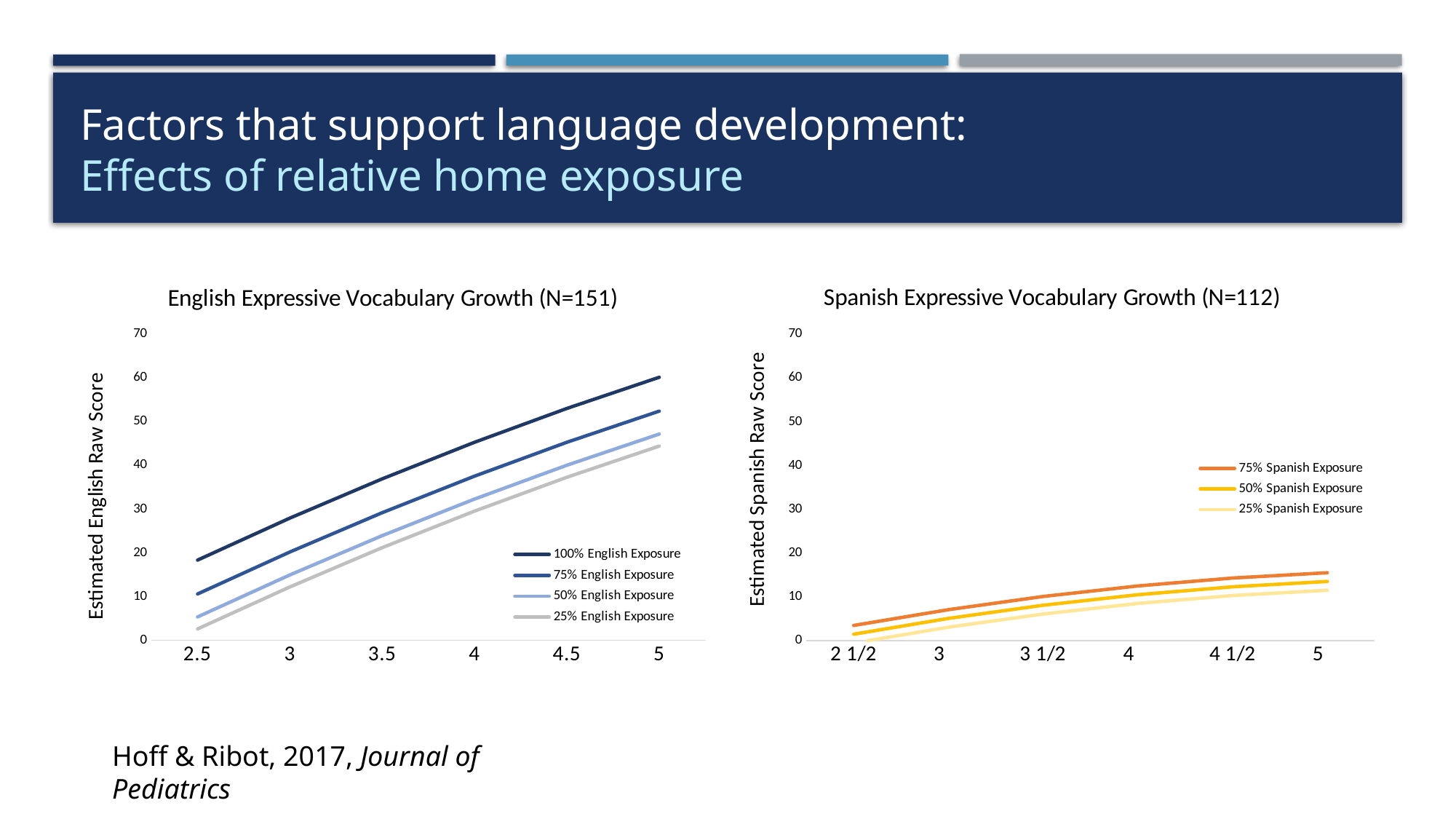
What is the sample size shown in the title of the Spanish Expressive Vocabulary Growth chart? N=112 In the Spanish Expressive Vocabulary Growth chart, which series has the lowest values across all ages? 25% Spanish Exposure How many series does the legend of the Spanish Expressive Vocabulary Growth chart list? 3 In the English Expressive Vocabulary Growth chart, at age 5, which is larger: the value for 100% English Exposure or for 25% English Exposure? 100% English Exposure In the English Expressive Vocabulary Growth chart, do the lines rise or fall as age increases along the x axis? rise How many series does the legend of the English Expressive Vocabulary Growth chart list? 4 In the English Expressive Vocabulary Growth chart, is the value for 100% English Exposure at age 5 greater or less than 50? greater What kind of chart is the English Expressive Vocabulary Growth chart? line chart In the English Expressive Vocabulary Growth chart, is the value for 25% English Exposure at age 2.5 greater or less than 10? less In the Spanish Expressive Vocabulary Growth chart, do the lines rise or fall as age increases along the x axis? rise In the English Expressive Vocabulary Growth chart, which series has the highest values across all ages? 100% English Exposure In the Spanish Expressive Vocabulary Growth chart, is the value for 75% Spanish Exposure at age 5 greater or less than 20? less